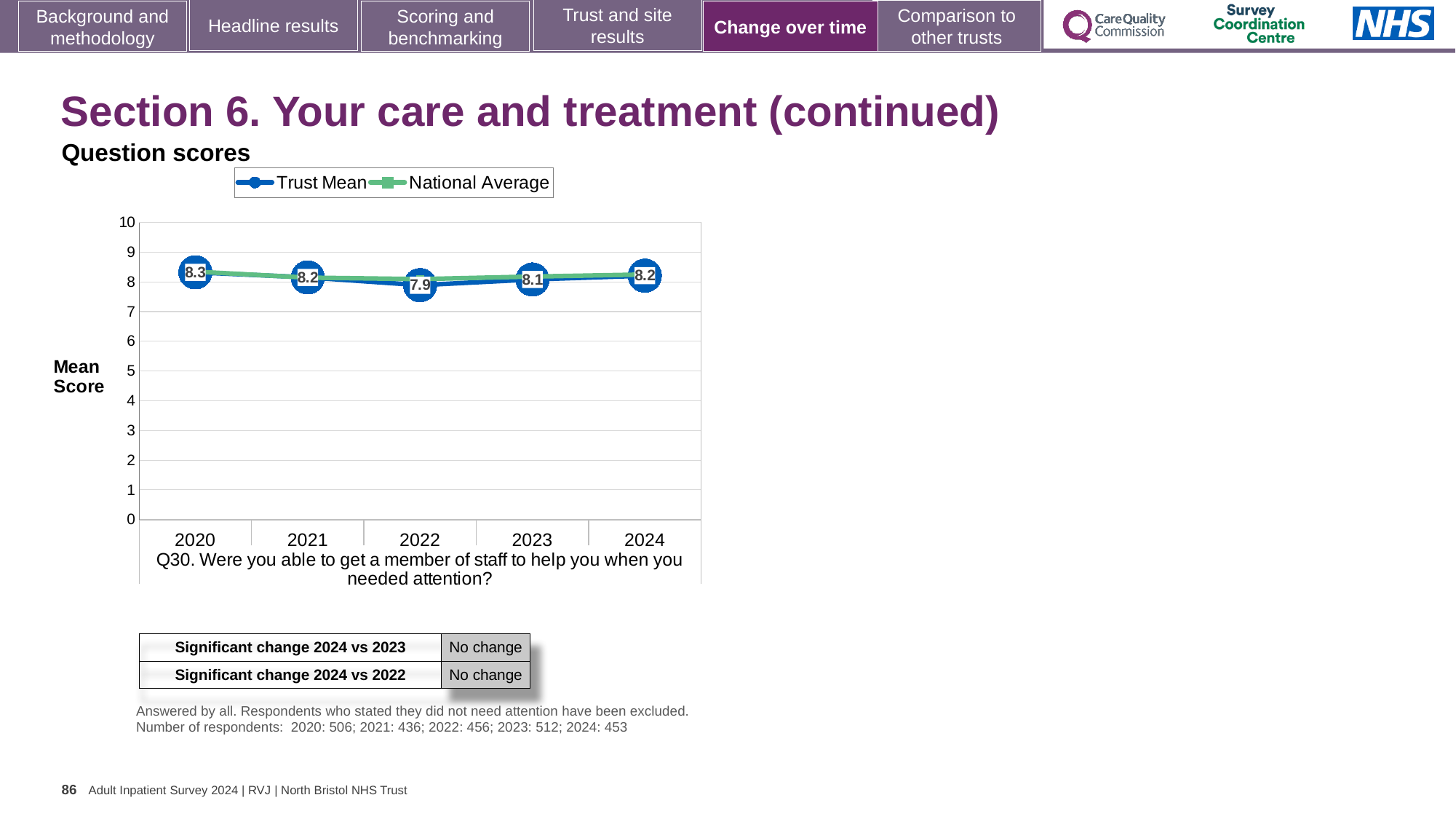
What is the Trust Mean score for 2024? 8.2 What kind of chart is shown on the slide? Line chart In which year is the Trust Mean score highest? 2020 Does the Trust Mean score rise or fall from 2022 to 2024? Rise In which year is the Trust Mean score lowest? 2022 What is the Trust Mean score for 2022? 7.9 How many years are shown on the x axis of the chart? 5 Which year has the larger Trust Mean score, 2021 or 2022? 2021 What is the Trust Mean score for 2020? 8.3 How many series does the chart legend list? 2 Is the National Average value for 2023 greater or less than 5? greater What is the difference between the Trust Mean score in 2020 and in 2022? 0.4